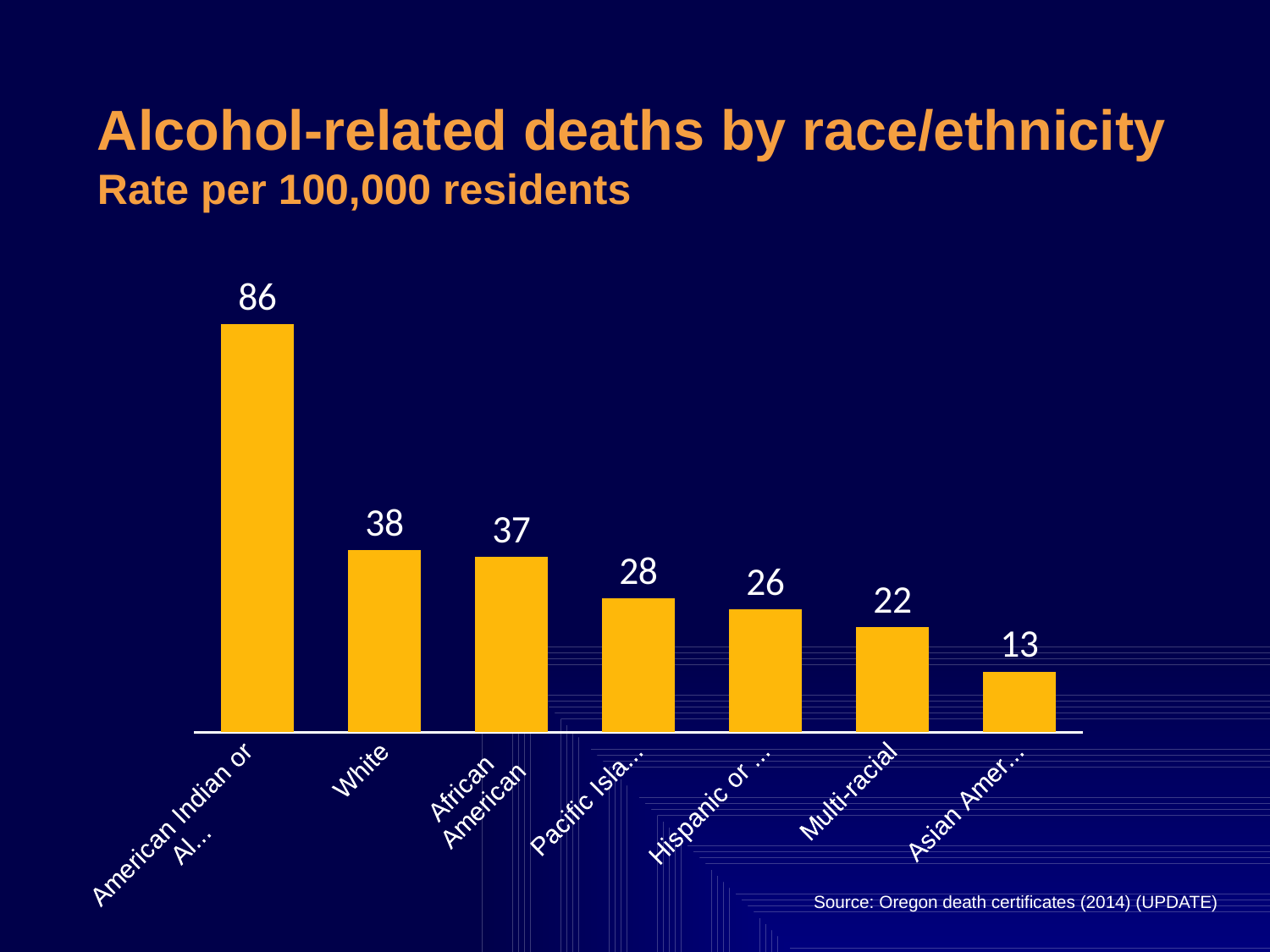
Which is larger, the rate for Pacific Isla... or the rate for Hispanic or ...? Pacific Isla... Which category has the lowest alcohol-related death rate? Asian Amer... What is the alcohol-related death rate per 100,000 residents for White residents? 38 What kind of chart is shown on the slide? Bar chart How many race/ethnicity categories are shown in the chart? 7 What is the value shown for the American Indian or Al... category? 86 What is the alcohol-related death rate per 100,000 residents for African American residents? 37 Do the values rise or fall moving from left to right across the categories? Fall What is the alcohol-related death rate per 100,000 residents for Multi-racial residents? 22 Which category has the highest alcohol-related death rate? American Indian or Al... What is the difference between the rate for American Indian or Al... and the rate for White? 48 What is the difference between the rate for Multi-racial and the rate for Asian Amer...? 9